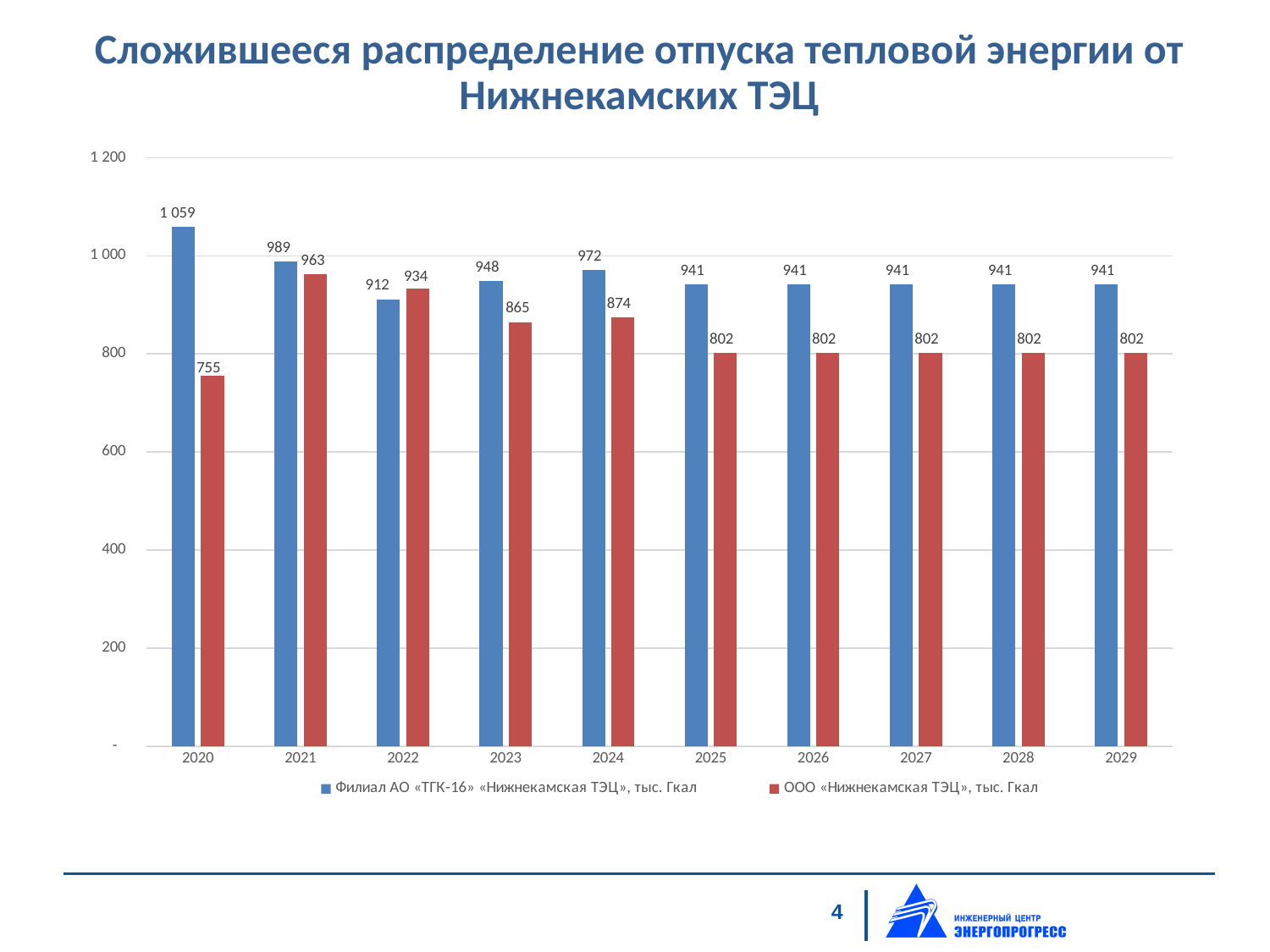
What is the value for Филиал АО «ТГК-16» «Нижнекамская ТЭЦ» in 2020? 1 059 What kind of chart is shown on the slide? Bar chart How many series does the legend list? 2 What is the value for ООО «Нижнекамская ТЭЦ» in 2023? 865 Which year has the lowest value for ООО «Нижнекамская ТЭЦ»? 2020 Do the values for ООО «Нижнекамская ТЭЦ» rise or fall from 2024 to 2025? Fall Which year has the highest value for Филиал АО «ТГК-16» «Нижнекамская ТЭЦ»? 2020 What is the difference between the two series in 2020? 304 Is the value for ООО «Нижнекамская ТЭЦ» in 2021 greater or less than 800? greater In 2022, which series has the larger value? ООО «Нижнекамская ТЭЦ», тыс. Гкал What colour are the bars for ООО «Нижнекамская ТЭЦ»? Red How many years are shown on the x axis? 10